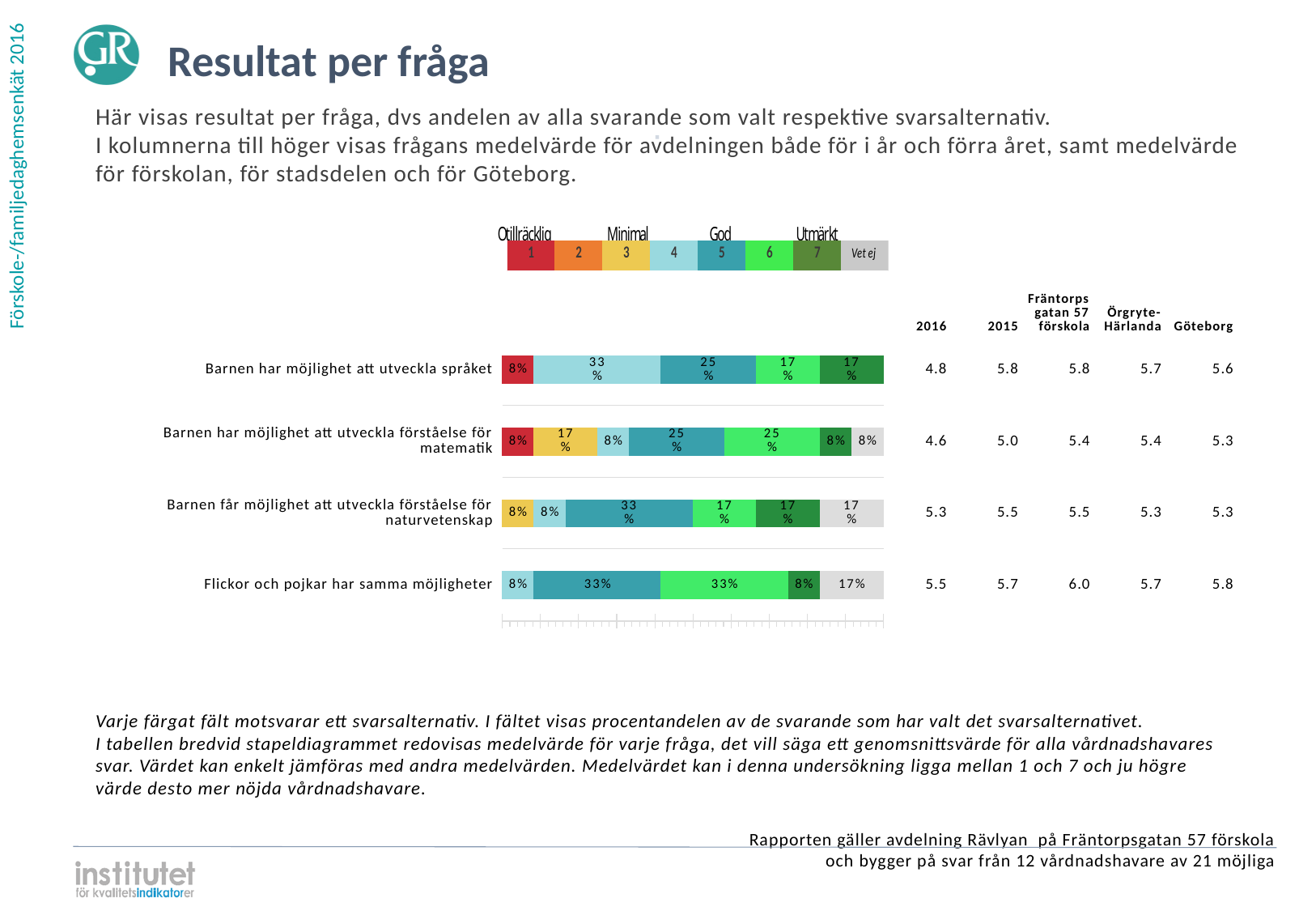
What percentage of respondents chose option 5 (teal) for 'Barnen får möjlighet att utveckla förståelse för naturvetenskap'? 33% What is the difference between the 2015 and 2016 mean values for 'Barnen har möjlighet att utveckla språket'? 1.0 What is the 2016 mean value for 'Barnen har möjlighet att utveckla förståelse för matematik'? 4.6 What percentage of respondents chose option 4 (light blue) for 'Barnen har möjlighet att utveckla språket'? 33% What is the title of the slide containing the chart? Resultat per fråga For 'Flickor och pojkar har samma möjligheter', which is larger: the Fräntorpsgatan 57 förskola mean or the Göteborg mean? Fräntorpsgatan 57 förskola How many response options does the legend above the chart list? 8 Which question has the highest 2016 mean value in the table? Flickor och pojkar har samma möjligheter What kind of chart is shown on the slide? Stacked bar chart Which question has the lowest 2016 mean value in the table? Barnen har möjlighet att utveckla förståelse för matematik How many questions (categories) are plotted as bars in the chart? 4 What percentage of respondents answered 'Vet ej' for 'Flickor och pojkar har samma möjligheter'? 17%